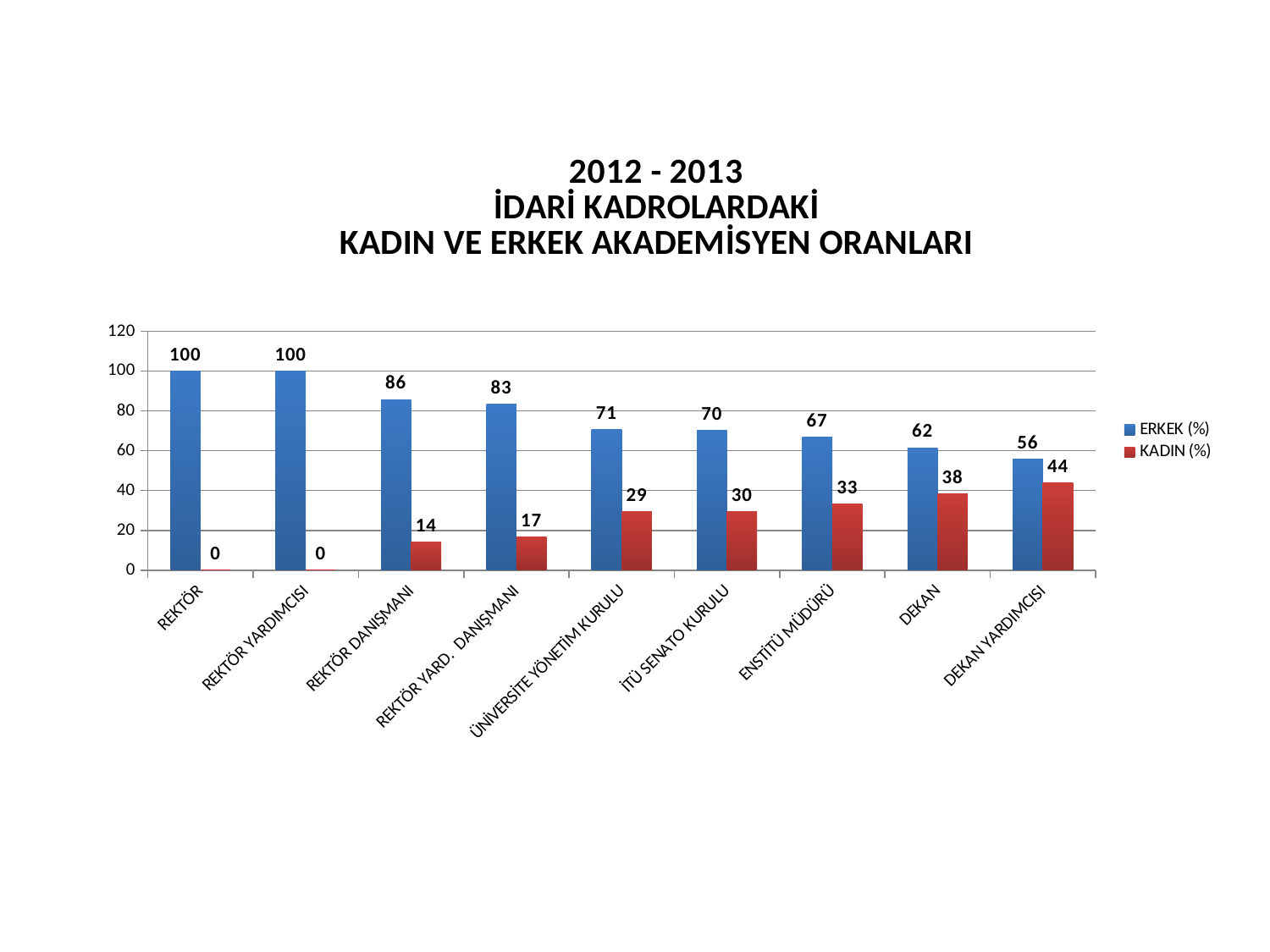
What is the KADIN (%) value for ENSTİTÜ MÜDÜRÜ? 33 Which category has the highest KADIN (%) value? DEKAN YARDIMCISI Is the ERKEK (%) value for ENSTİTÜ MÜDÜRÜ greater or less than 60? greater What is the ERKEK (%) value for DEKAN? 62 How many series does the legend list? 2 Which is larger, the KADIN (%) value for İTÜ SENATO KURULU or for REKTÖR YARD. DANIŞMANI? İTÜ SENATO KURULU Which category has the lowest ERKEK (%) value? DEKAN YARDIMCISI Do the ERKEK (%) values rise or fall from left to right along the x axis? fall How many categories are shown on the x axis? 9 What is the difference between the ERKEK (%) and KADIN (%) values for ÜNİVERSİTE YÖNETİM KURULU? 42 What is the KADIN (%) value for REKTÖR DANIŞMANI? 14 What kind of chart is shown on the slide? bar chart